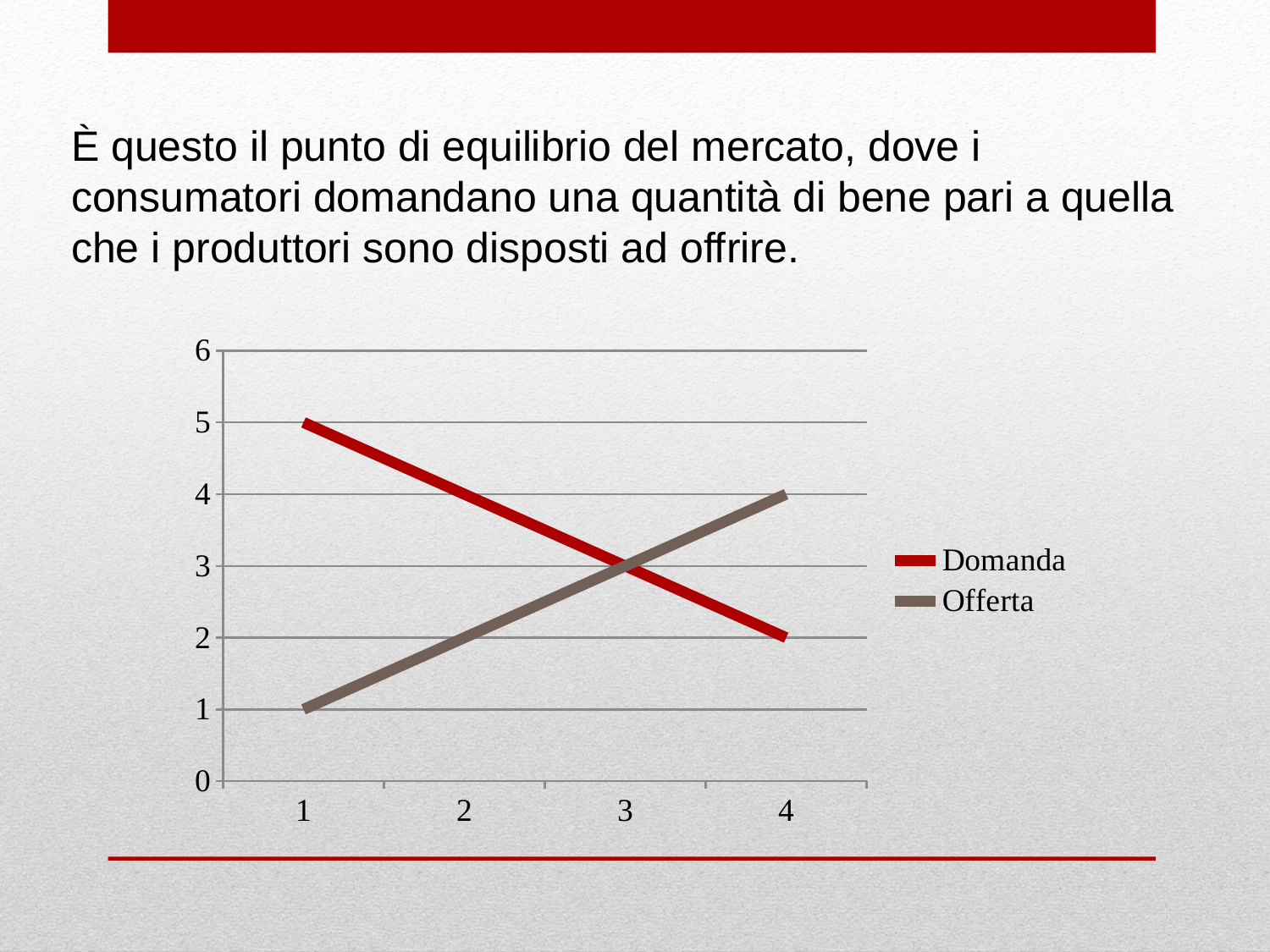
How many points are plotted along the x axis for each series? 4 Does the Offerta line rise or fall as x increases? rise What are the names of the two series in the legend? Domanda and Offerta What is the difference between Domanda and Offerta at x = 1? 4 What kind of chart is shown on the slide? line chart How many series does the legend list? 2 Does the Domanda line rise or fall as x increases? fall What is the value of Offerta at x = 1? 1 What is the value of Domanda at x = 1? 5 What is the value of Offerta at x = 4? 4 At x = 1, which series has the larger value, Domanda or Offerta? Domanda What is the value of Domanda at x = 4? 2